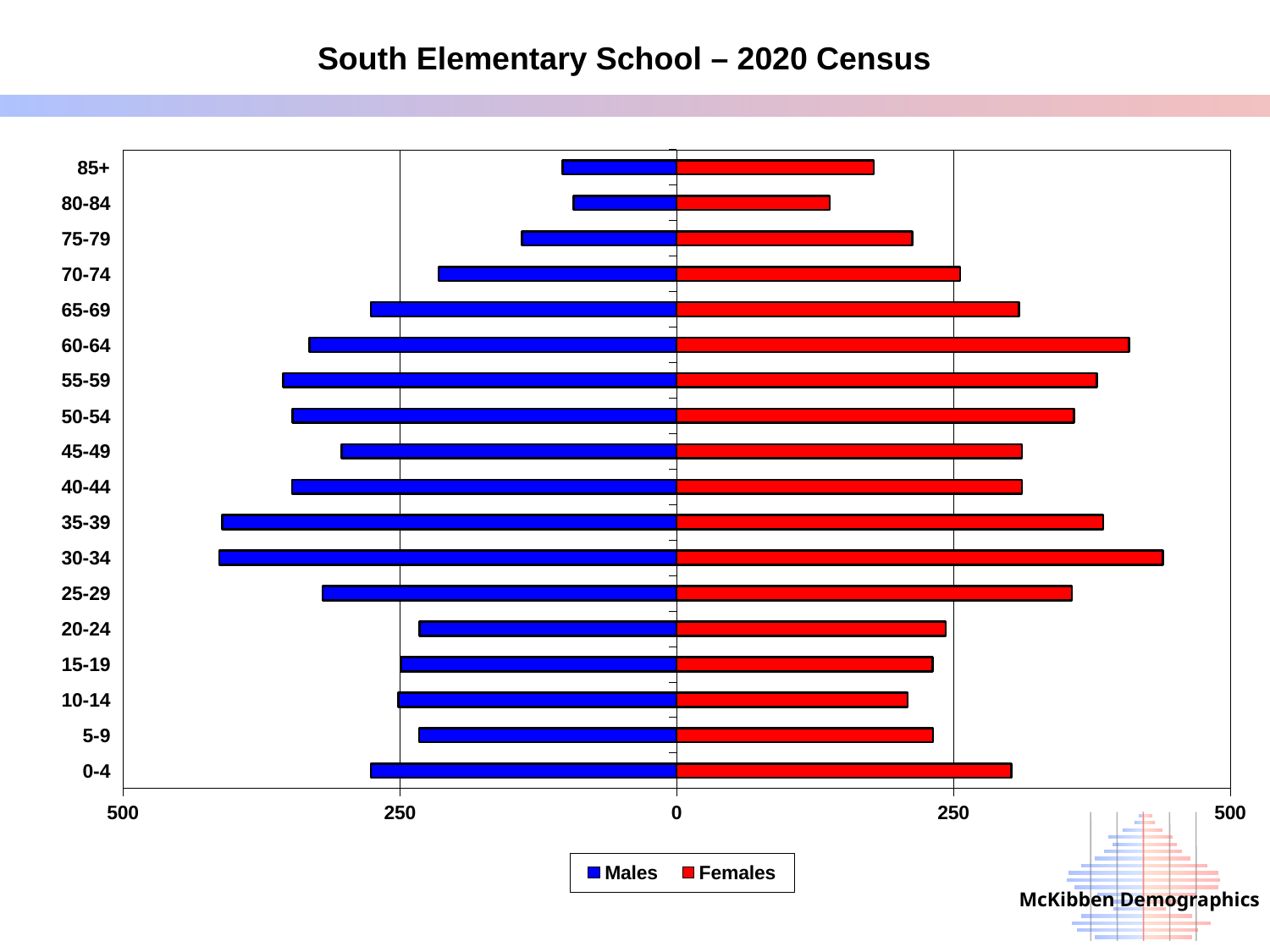
Is the value for Females in the 60-64 age group greater or less than 250? greater Is the value for Females in the 85+ age group greater or less than 250? less In the 85+ age group, which is larger, the value for Males or the value for Females? Females What is the title of the chart? South Elementary School – 2020 Census What kind of chart is shown on the slide? bar chart Which age group has the lowest value for Females? 80-84 Is the value for Females in the 0-4 age group greater or less than 250? greater Which age group has the highest value for Females? 30-34 How many series does the legend list? 2 Which colour represents Females in the chart? red How many age groups are shown on the chart? 18